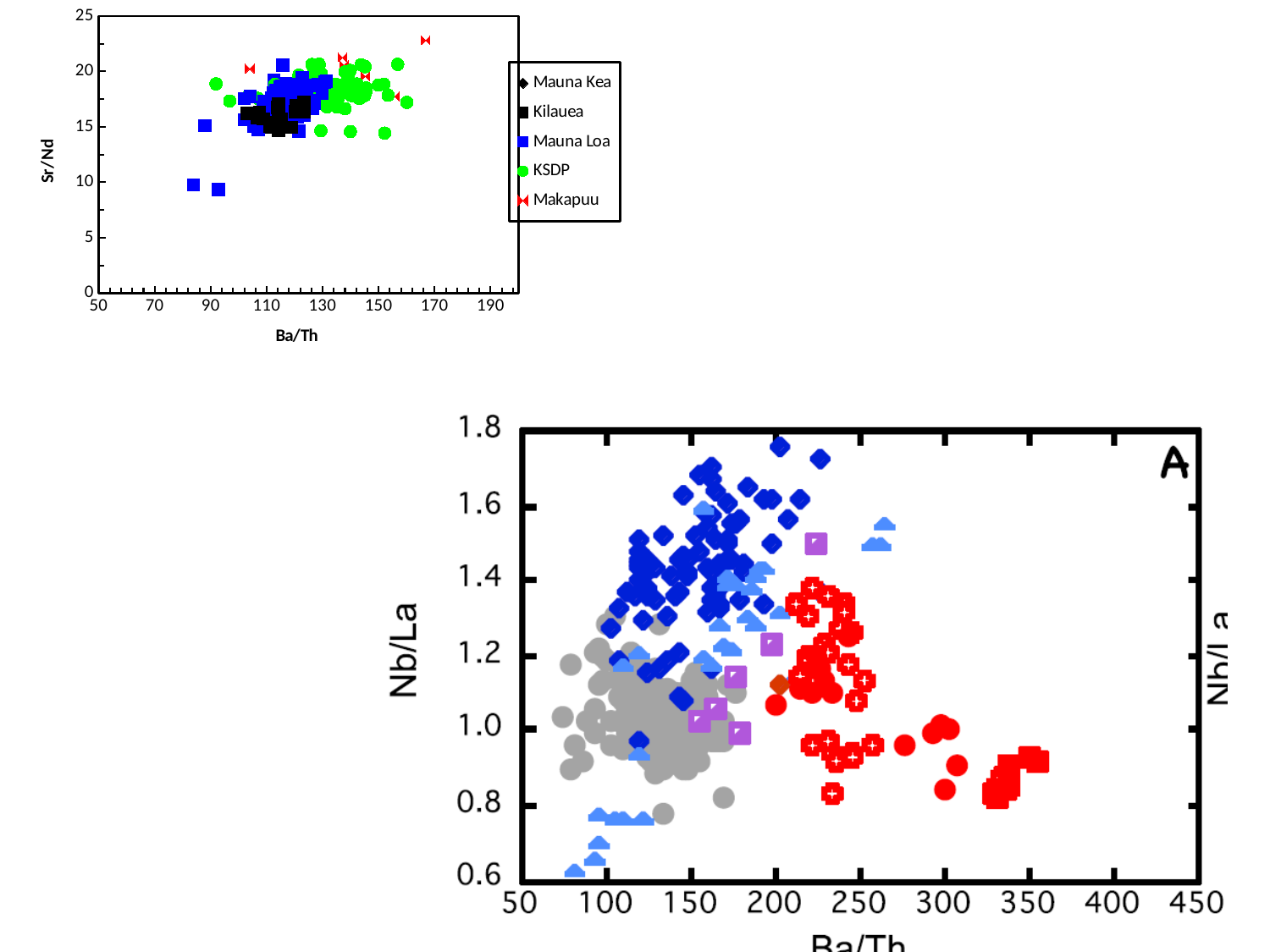
In the bottom-right chart, is the highest Nb/La value plotted greater or less than 1.6? greater What kind of chart is the top-left chart with Sr/Nd on the y axis? scatter chart In the top-left chart, is the highest Makapuu point's Sr/Nd value greater or less than 20? greater In the bottom-right chart, are the red points mostly at Ba/Th values greater or less than 200? greater In the bottom-right chart, what is the label on the y axis? Nb/La In the top-left chart, which series has the point with the highest Ba/Th value? Makapuu In the top-left chart, what colour are the KSDP points? green In the top-left chart, how many series does the legend list? 5 In the top-left chart, which series has the point with the lowest Sr/Nd value? Mauna Loa In the top-left chart, which series has the point with the highest Sr/Nd value? Makapuu